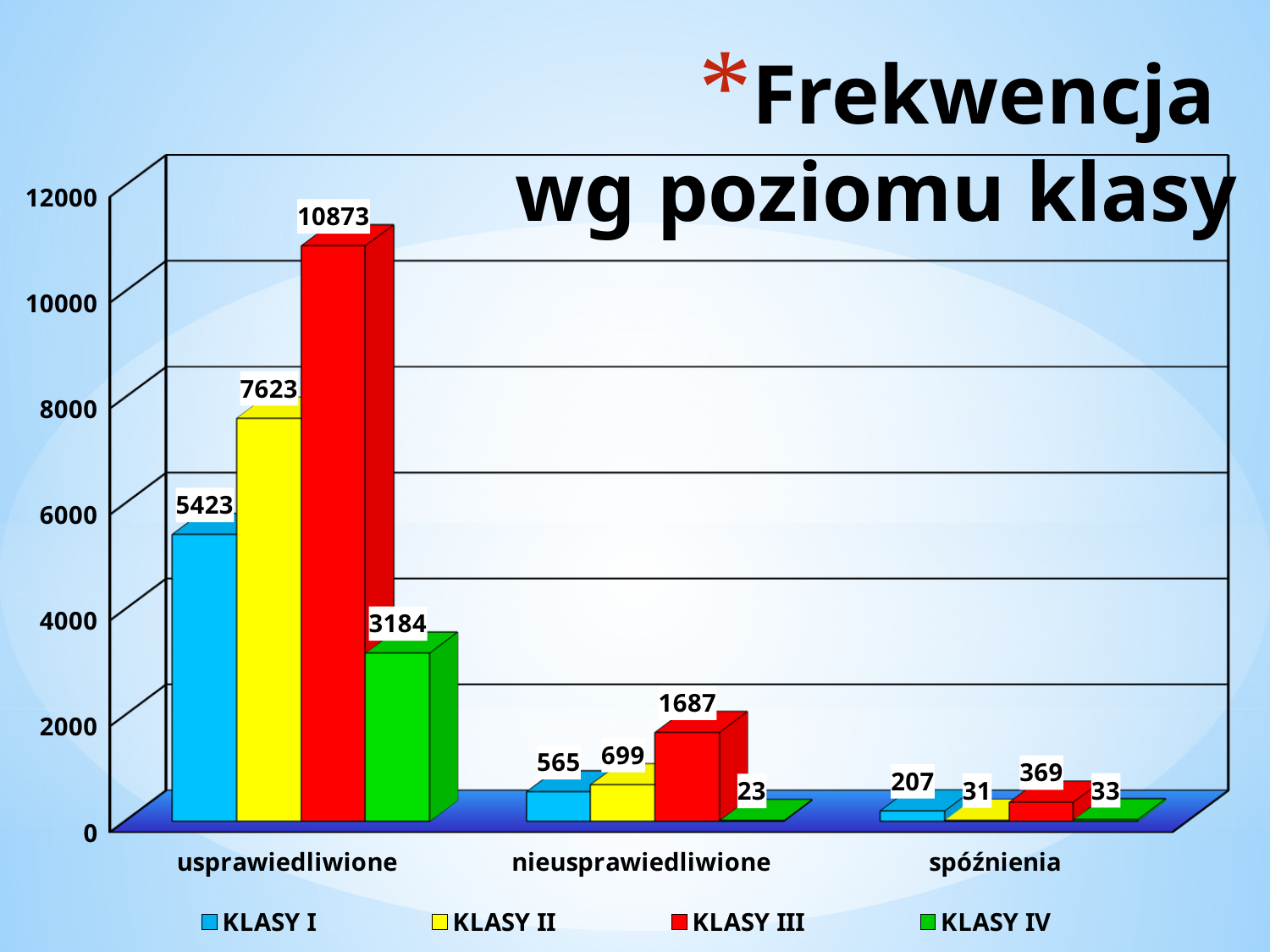
What is the value for KLASY I in the nieusprawiedliwione category? 565 How many series does the legend list? 4 Which series has the lowest value in the nieusprawiedliwione category? KLASY IV What is the difference between the KLASY II and KLASY I values in the usprawiedliwione category? 2200 What is the value for KLASY IV in the spóźnienia category? 33 What is the value for KLASY III in the usprawiedliwione category? 10873 How many categories are shown on the x axis? 3 What colour represents KLASY II in the chart? yellow Which series has the highest value in the usprawiedliwione category? KLASY III Is the value for KLASY IV in the usprawiedliwione category greater or less than 4000? less Which is larger in the spóźnienia category: the value for KLASY I or the value for KLASY III? KLASY III What kind of chart is shown on the slide? bar chart